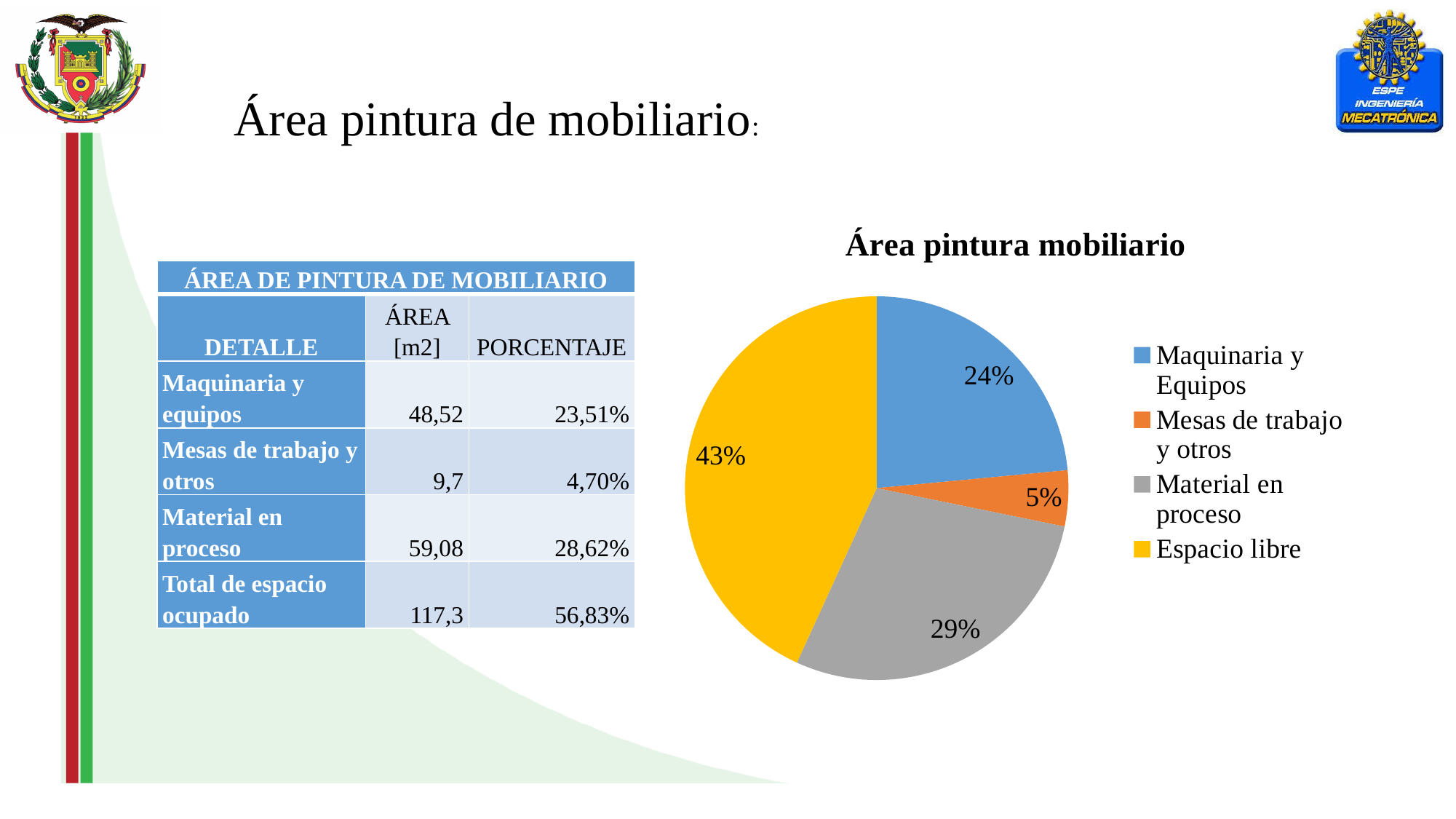
What type of chart is shown on the slide? pie chart What share of the pie does Espacio libre take? 43% What share of the pie does Maquinaria y Equipos take? 24% Which is larger, the slice for Material en proceso or the slice for Maquinaria y Equipos? Material en proceso What colour is the Espacio libre slice in the pie chart? yellow What is the difference in percentage points between the Espacio libre slice and the Material en proceso slice? 14% What share of the pie does Material en proceso take? 29% What is the title of the chart? Área pintura mobiliario Which category has the smallest slice of the pie? Mesas de trabajo y otros Which category has the largest slice of the pie? Espacio libre How many slices does the pie chart have? 4